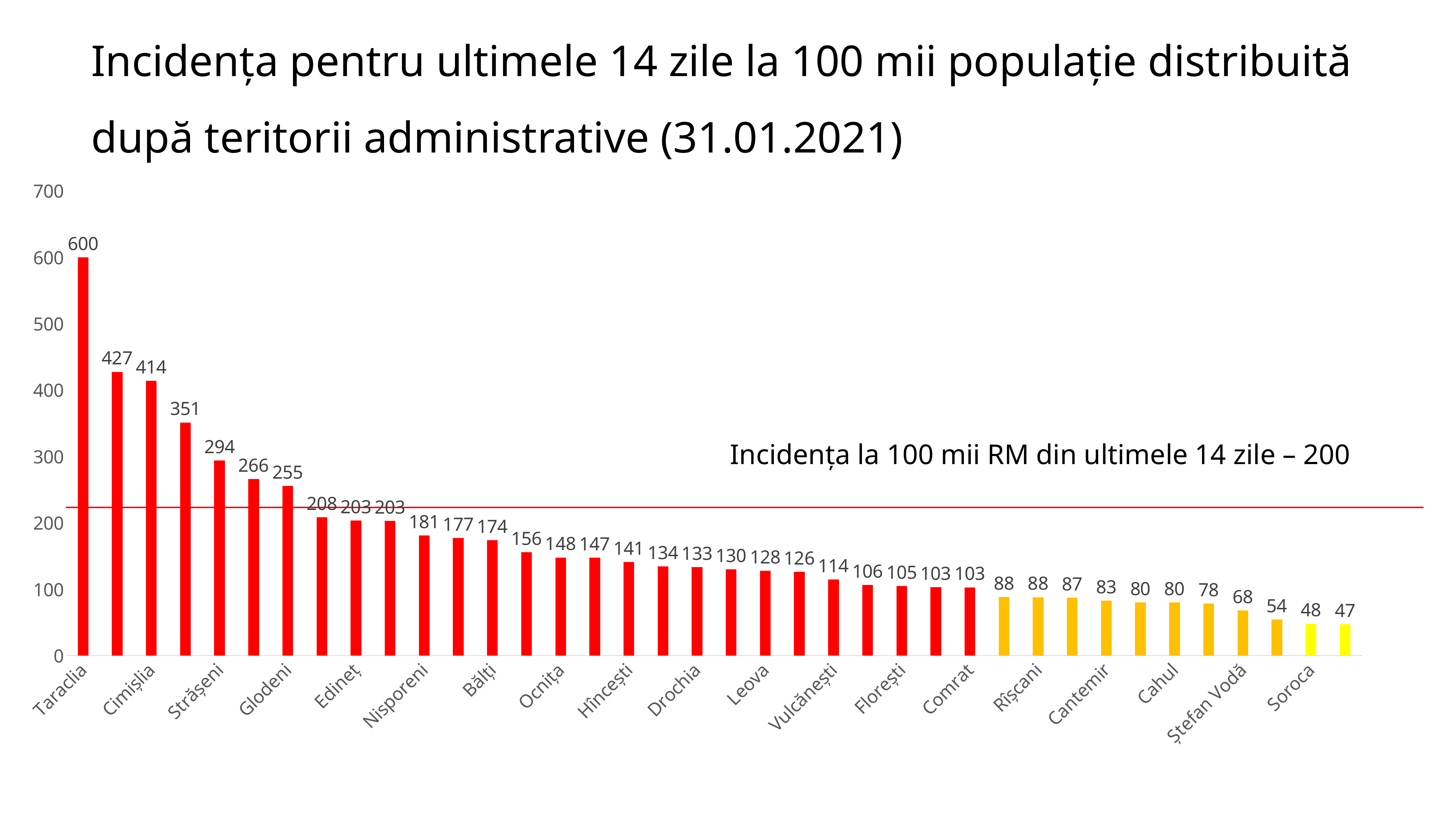
What is the difference between the values for Taraclia and Cimișlia? 186 What value does the horizontal reference line label give for the national incidence per 100 thousand in the last 14 days? 200 What is the incidence value for Taraclia? 600 What type of chart is shown on the slide? bar chart Which territory has the highest incidence value in the chart? Taraclia What is the incidence value for Strășeni? 294 What is the incidence value for Cimișlia? 414 What is the lowest value shown on any bar in the chart? 47 Do the bar values rise or fall from left to right along the x axis? fall What is the incidence value for Bălți? 174 What is the incidence value for Soroca? 48 Which has a higher incidence value, Strășeni or Glodeni? Strășeni